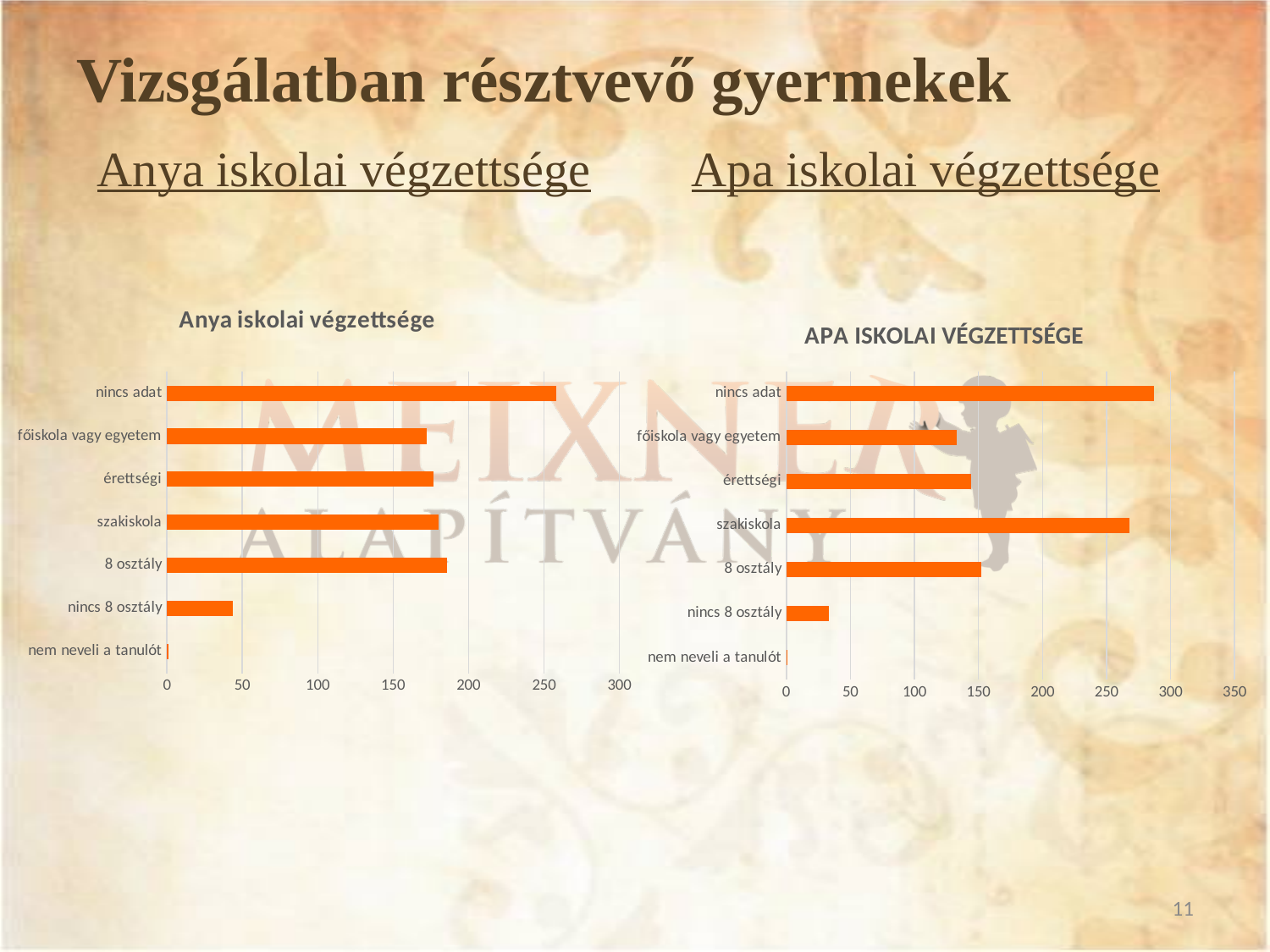
In the chart titled "APA ISKOLAI VÉGZETTSÉGE", is the value for főiskola vagy egyetem greater or less than 150? less In the chart titled "Anya iskolai végzettsége", is the value for nincs 8 osztály greater or less than 50? less In the chart titled "Anya iskolai végzettsége", is the value for nincs adat greater or less than 250? greater In the chart titled "APA ISKOLAI VÉGZETTSÉGE", which is larger, the value for szakiskola or the value for érettségi? szakiskola In the chart titled "APA ISKOLAI VÉGZETTSÉGE", which category has the highest value? nincs adat In the chart titled "Anya iskolai végzettsége", what kind of chart is shown? bar chart In the chart titled "Anya iskolai végzettsége", how many categories are plotted? 7 What is the title of the chart on the right side of the slide? APA ISKOLAI VÉGZETTSÉGE In the chart titled "Anya iskolai végzettsége", which category has the highest value? nincs adat In the chart titled "Anya iskolai végzettsége", which category has the lowest value? nem neveli a tanulót In the chart titled "Anya iskolai végzettsége", which is larger, the value for 8 osztály or the value for nincs 8 osztály? 8 osztály